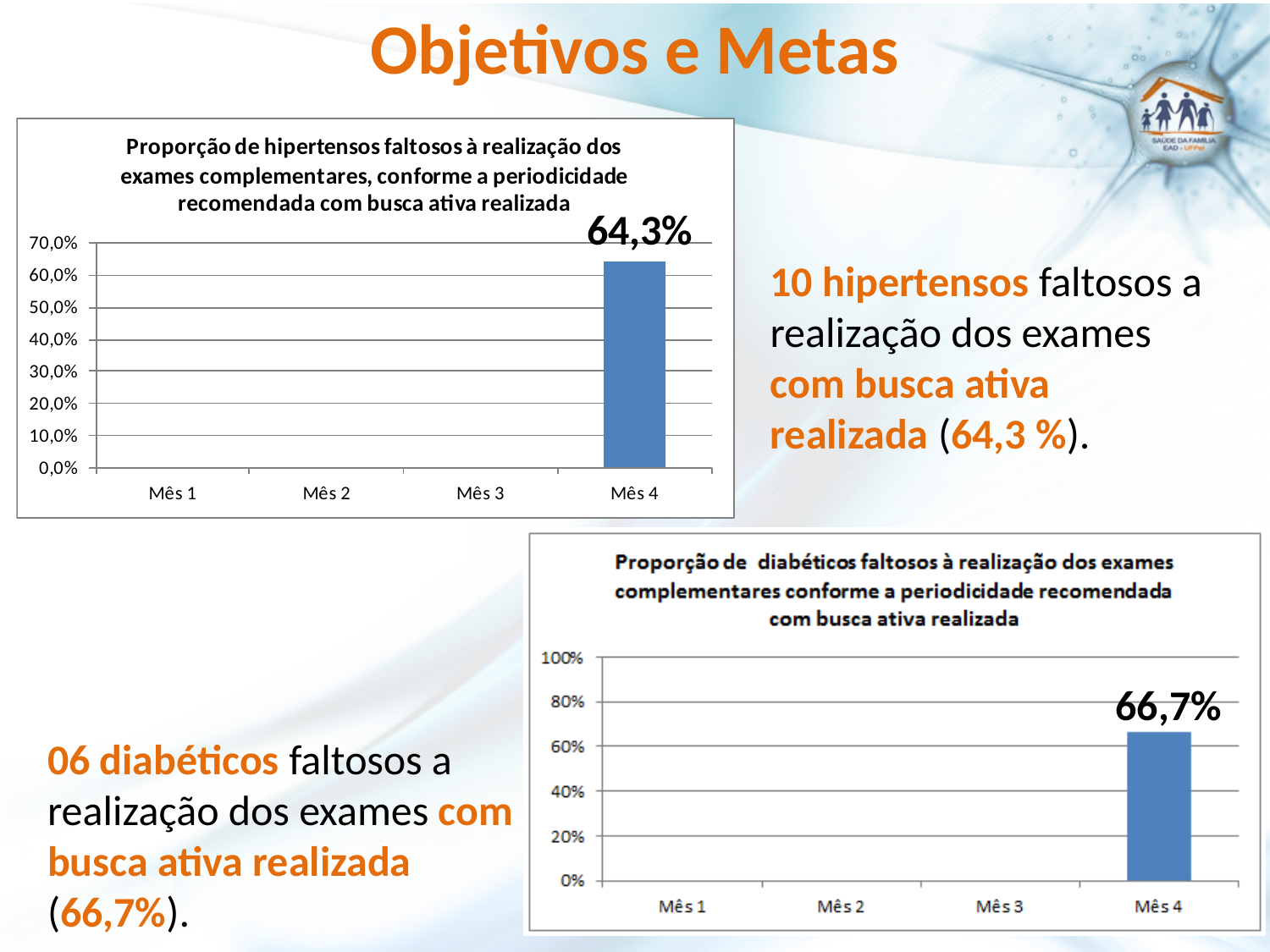
What is the highest tick value on the y axis of the bottom-right chart (diabéticos faltosos)? 100% What kind of chart is the bottom-right chart (diabéticos faltosos)? Bar chart How many categories are shown on the x axis of the top-left chart (hipertensos faltosos)? 4 In the top-left chart (hipertensos faltosos), which month has the highest value? Mês 4 In the top-left chart (hipertensos faltosos), is the value for Mês 4 greater or less than 60,0%? greater In the bottom-right chart (diabéticos faltosos), is the value for Mês 4 greater or less than 80%? less Which is larger: the Mês 4 value in the top-left chart (hipertensos) or the Mês 4 value in the bottom-right chart (diabéticos)? The bottom-right chart (diabéticos), 66,7% How many categories are shown on the x axis of the bottom-right chart (diabéticos faltosos)? 4 In the top-left chart (hipertensos faltosos), what is the value for Mês 4? 64,3% In the bottom-right chart (diabéticos faltosos), which month has the highest value? Mês 4 What kind of chart is the top-left chart (hipertensos faltosos)? Bar chart In the bottom-right chart (diabéticos faltosos), what is the value for Mês 4? 66,7%